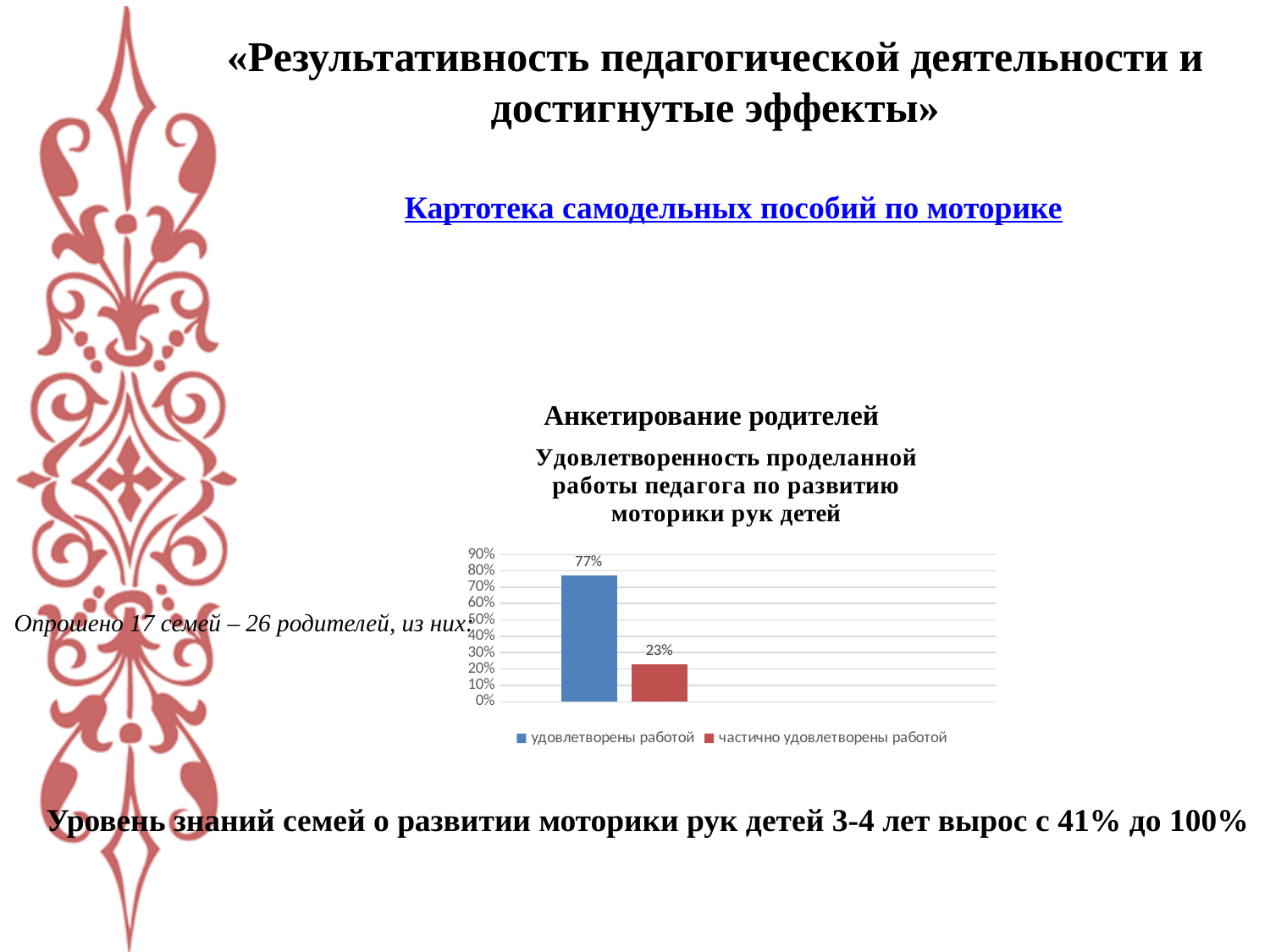
What kind of chart is shown on the slide? bar chart What value is shown for "частично удовлетворены работой"? 23% What is the title of the chart? Удовлетворенность проделанной работы педагога по развитию моторики рук детей Which series has the highest value? удовлетворены работой Which is larger: "удовлетворены работой" or "частично удовлетворены работой"? удовлетворены работой What is the difference between the values for "удовлетворены работой" and "частично удовлетворены работой"? 54% Which series has the lowest value? частично удовлетворены работой What value is shown for "удовлетворены работой"? 77% How many series does the legend list? 2 What colour is the bar for "частично удовлетворены работой"? red Is the value for "частично удовлетворены работой" greater or less than 30%? less Is the value for "удовлетворены работой" greater or less than 70%? greater